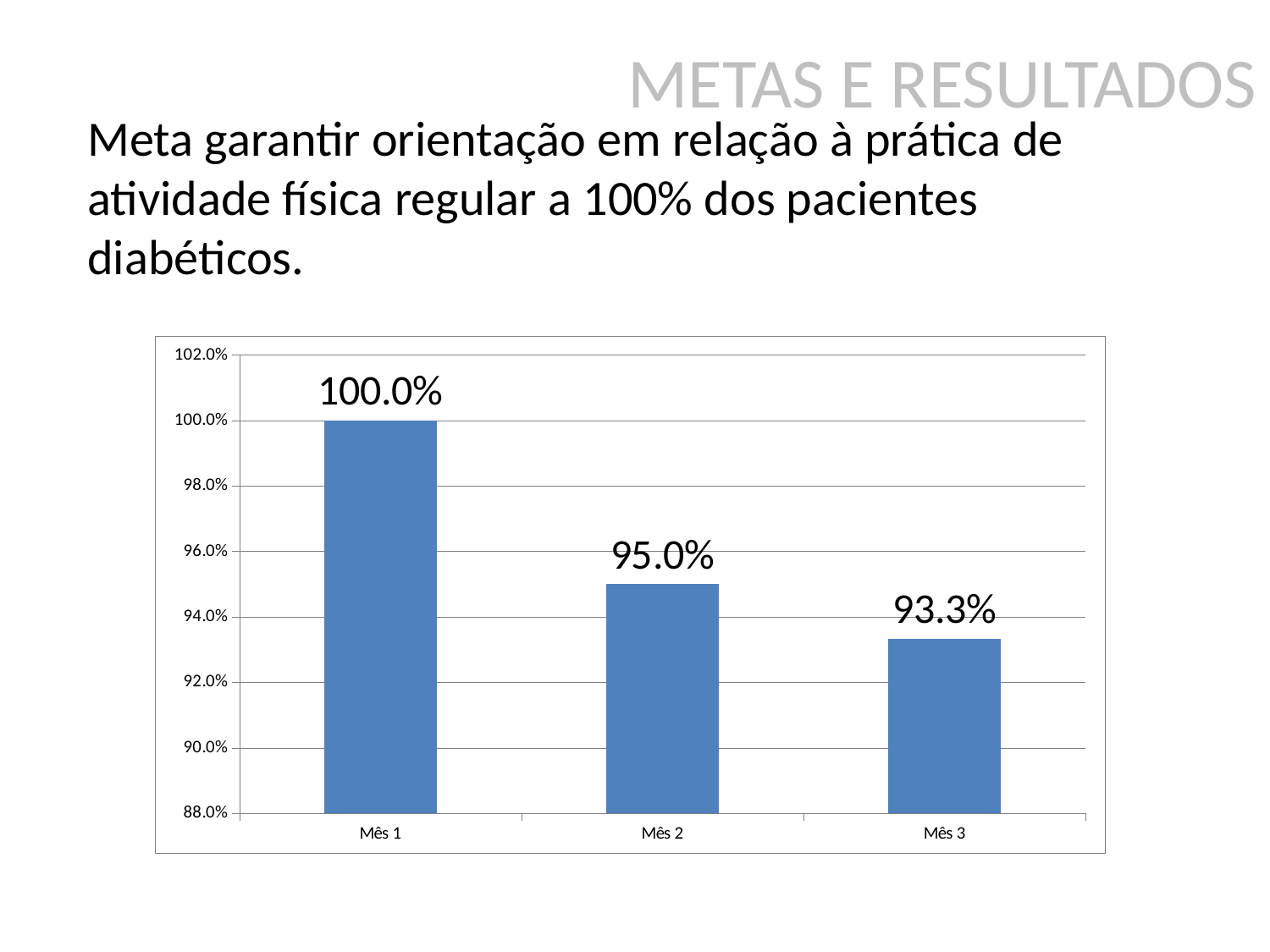
What is the value for Mês 1? 100.0% Which month has the highest value? Mês 1 How many categories are shown on the x axis? 3 Is the value for Mês 3 greater or less than 94.0%? less What kind of chart is shown on the slide? bar chart What is the difference between the values for Mês 1 and Mês 2? 5.0% Which month has the lowest value? Mês 3 What is the value for Mês 2? 95.0% What is the value for Mês 3? 93.3% What is the difference between the values for Mês 2 and Mês 3? 1.7% Which is larger, the value for Mês 2 or the value for Mês 3? Mês 2 Do the values rise or fall from Mês 1 to Mês 3? fall